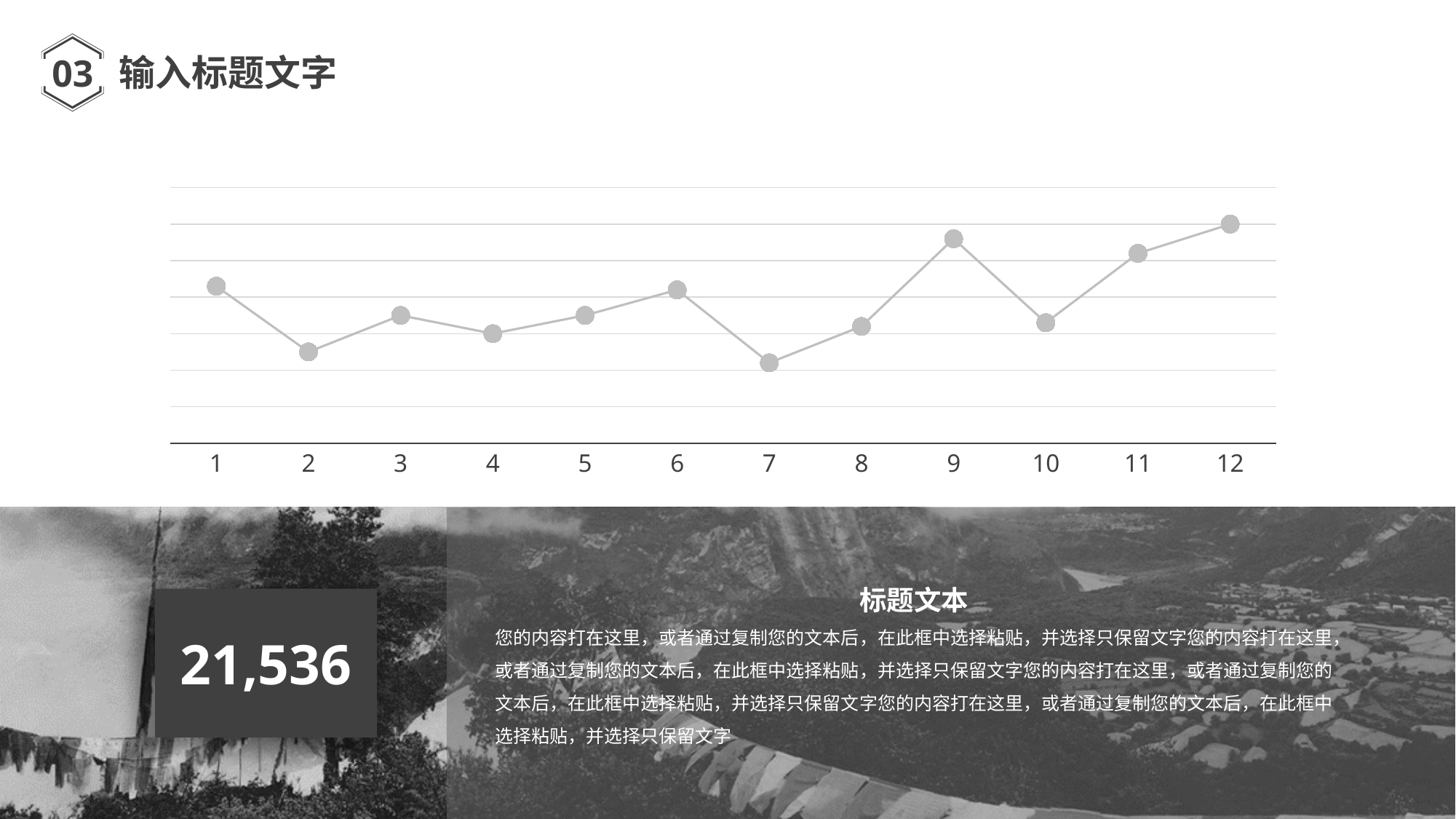
How many data points are plotted on the line chart? 12 Which has the larger value on the line chart, category 6 or category 7? 6 Does the line rise or fall from category 7 to category 9? rise Which x-axis category has the lowest value on the line chart? 7 Which x-axis category has the highest value on the line chart? 12 What kind of chart is shown on the slide? line chart Which has the larger value on the line chart, category 1 or category 2? 1 Does the line rise or fall from category 1 to category 2? fall Which has the larger value on the line chart, category 9 or category 10? 9 What are the first and last labels on the x axis of the line chart? 1 and 12 Does the line rise or fall from category 10 to category 12? rise